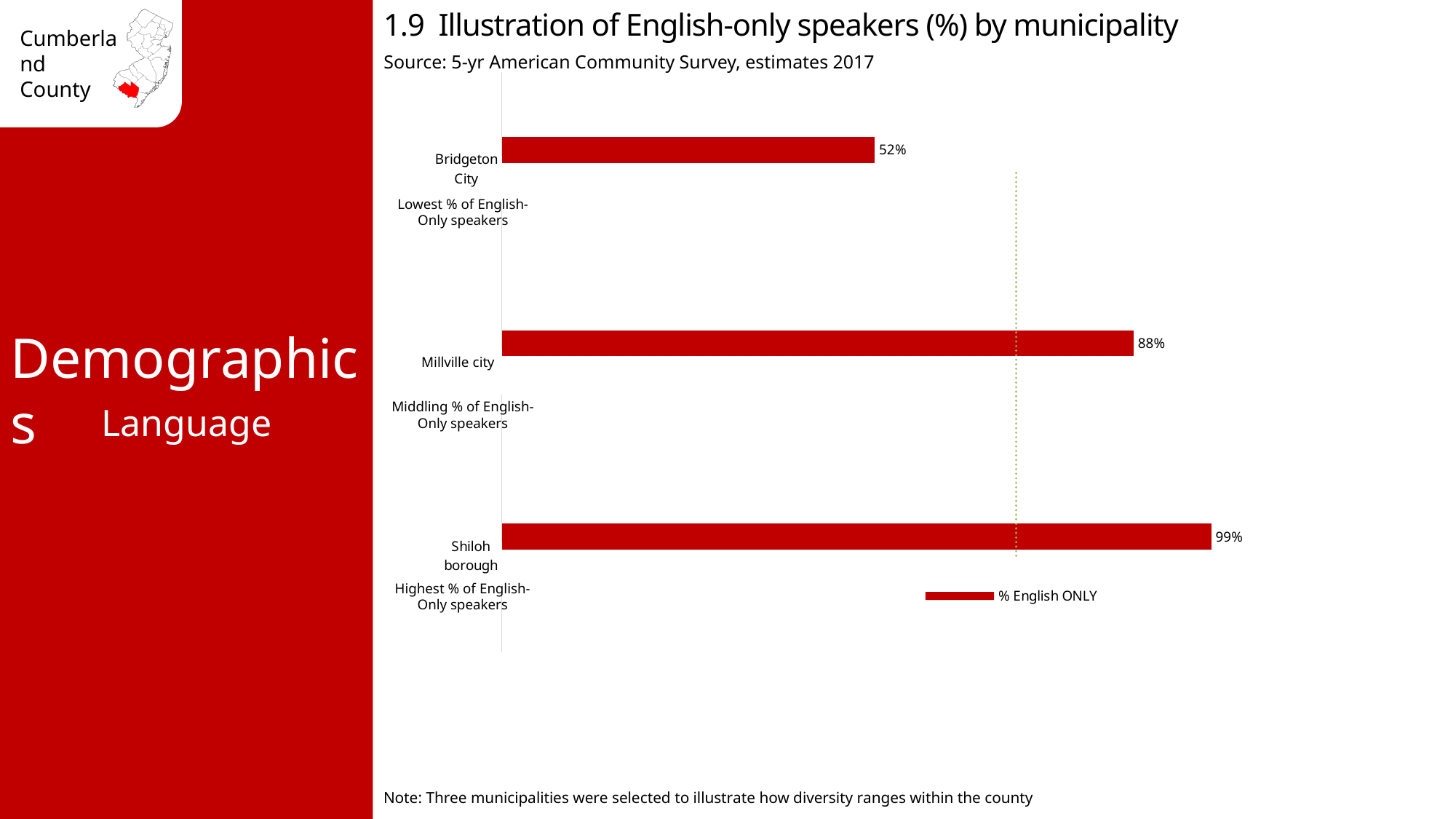
How many municipalities are shown in the chart? 3 What is the legend entry for the series shown in the chart? % English ONLY What is the value for Bridgeton City? 52% Which municipality has the lowest percentage of English-only speakers? Bridgeton City How many series does the legend list? 1 What is the difference between the values for Shiloh borough and Bridgeton City? 47% What kind of chart is shown on the slide? Bar chart What is the value for Millville city? 88% What is the difference between the values for Millville city and Bridgeton City? 36% What is the value for Shiloh borough? 99% Which municipality has the highest percentage of English-only speakers? Shiloh borough Which has a larger value, Millville city or Bridgeton City? Millville city